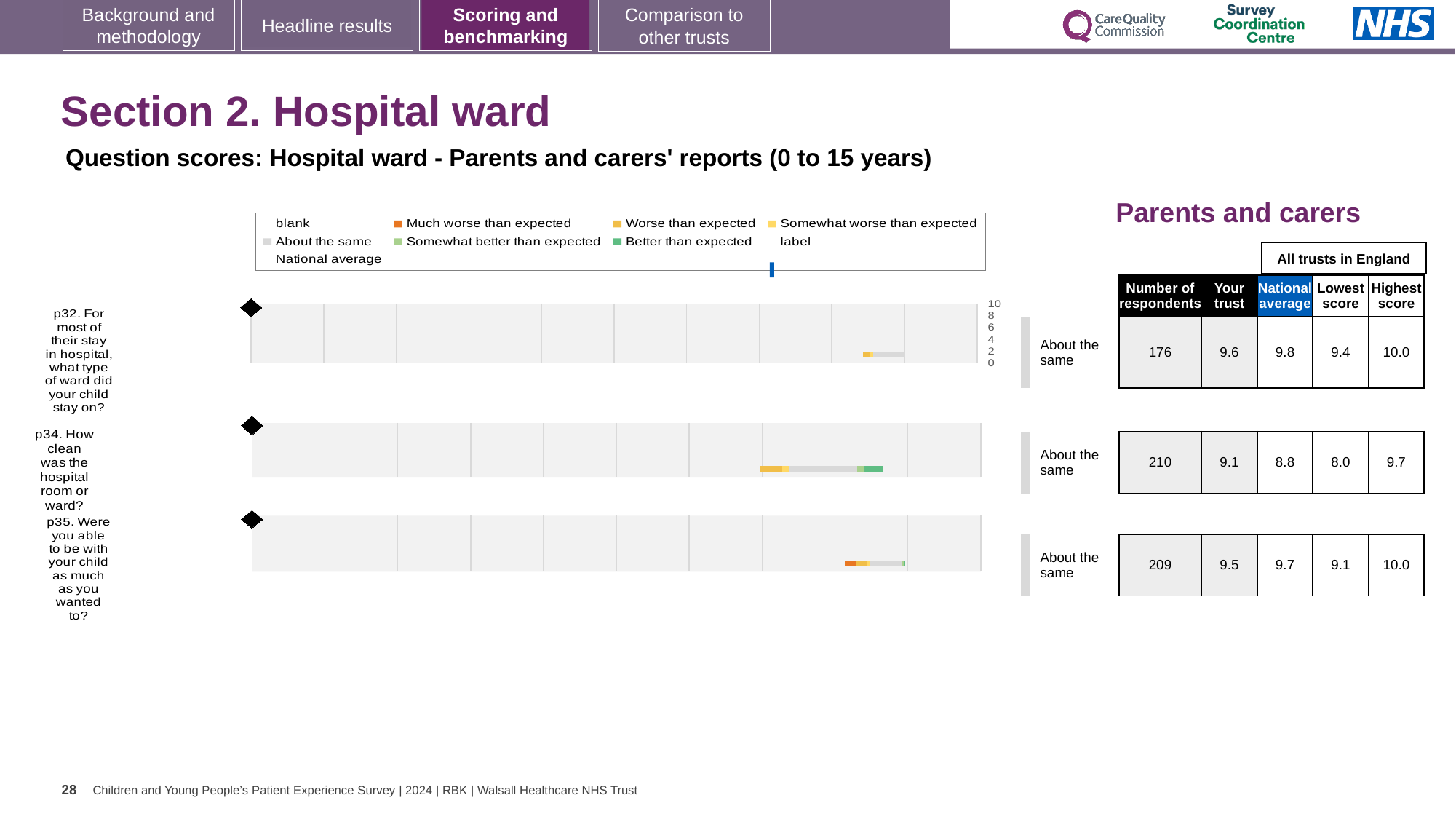
How many respondents answered p35 (Were you able to be with your child as much as you wanted to)? 209 For p32, which is larger: the 'Your trust' score or the National average? National average How many entries does the chart legend list? 9 What type of chart is used to show the question scores on this slide? bar chart What benchmark category is shown next to each of the three questions? About the same How many questions (p32, p34, p35) are plotted on the slide? 3 What is the Highest score across all trusts in England for p35? 10.0 Which question has the highest 'Your trust' score? p32 For p34, what is the difference between the Highest score and the Lowest score across all trusts in England? 1.7 What is the 'Your trust' score for p34 (How clean was the hospital room or ward?)? 9.1 Which question has the lowest 'Your trust' score? p34 What is the National average score for p32 (what type of ward did your child stay on)? 9.8